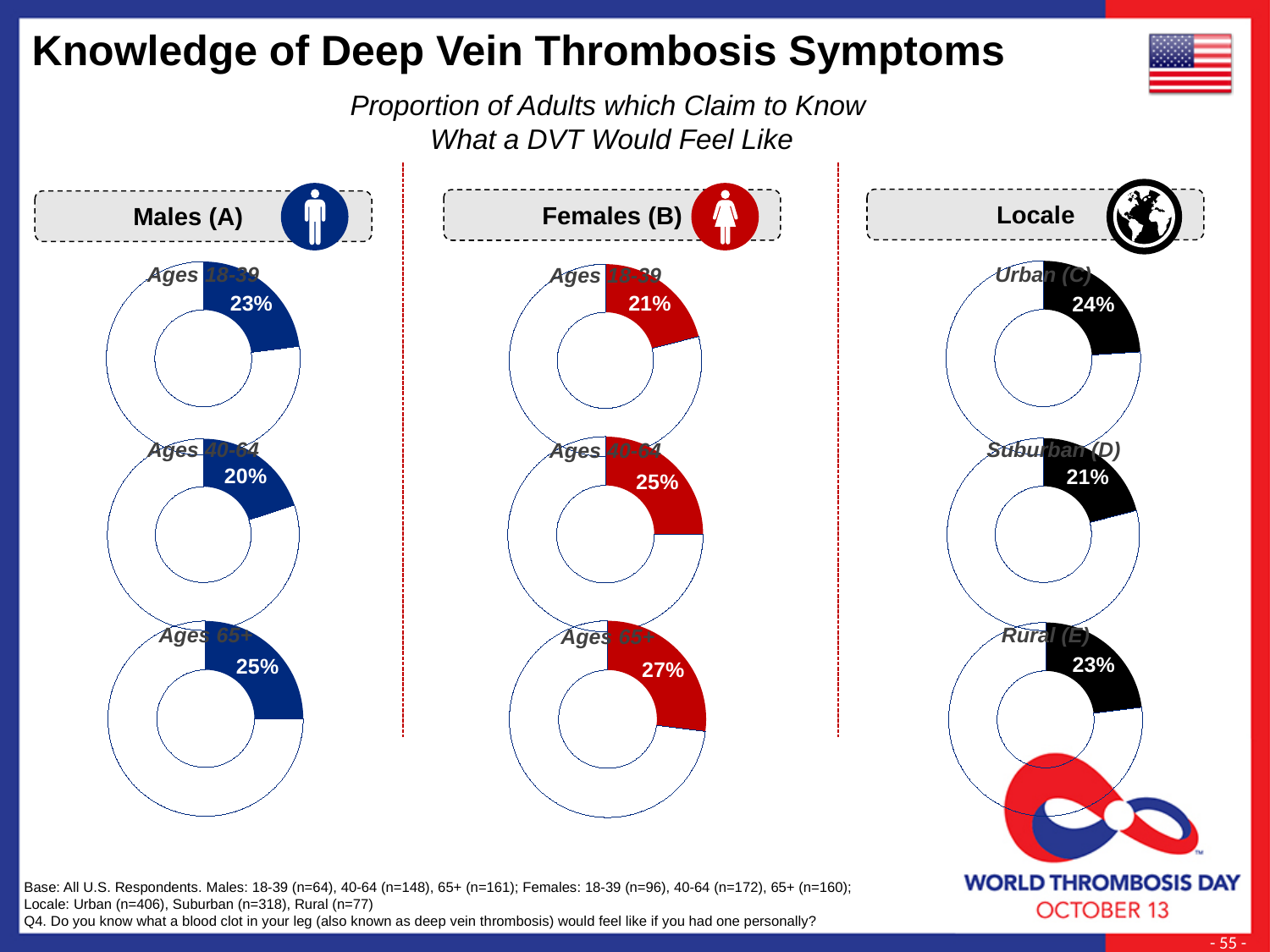
In the Females (B) column, which age group has the highest percentage? Ages 65+ What is the difference between the Females (B) Ages 65+ value and the Males (A) Ages 65+ value? 2% How many donut charts are shown on the slide in total? 9 In the Locale column, what percentage is shown for Suburban (D)? 21% In the Females (B) column, what percentage is shown for Ages 65+? 27% What is the difference between the Urban (C) and Suburban (D) values in the Locale column? 3% Which is larger: the Males (A) Ages 40-64 value or the Females (B) Ages 40-64 value? Females (B) Ages 40-64 In the Males (A) column, which age group has the lowest percentage? Ages 40-64 In the Locale column, which locale has the highest percentage? Urban (C) In the Males (A) column, what percentage is shown for Ages 18-39? 23% What type of chart is used to show the Males (A) Ages 18-39 value? Donut (pie) chart In the Males (A) column, what percentage is shown for Ages 40-64? 20%